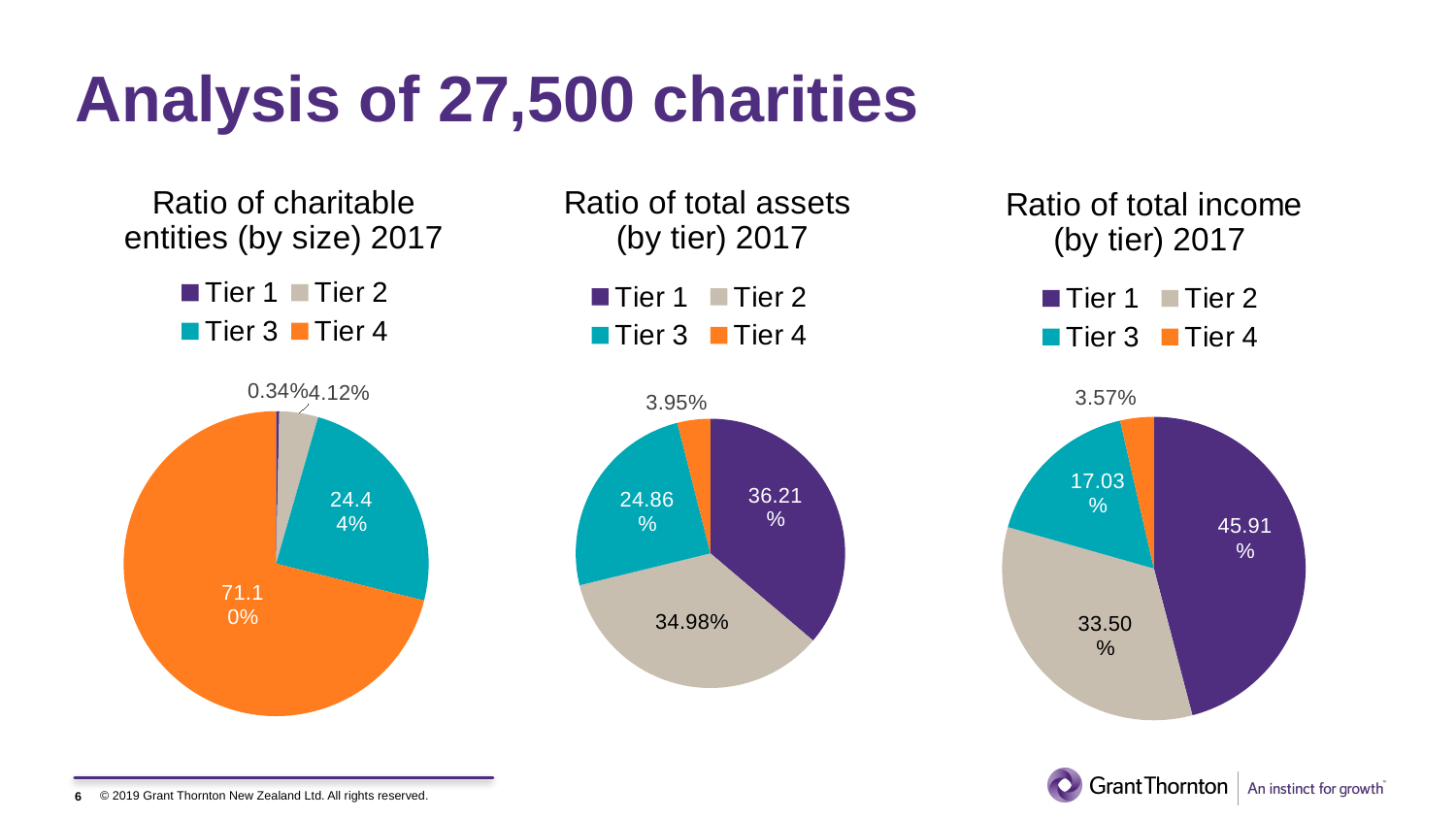
In the 'Ratio of total assets (by tier) 2017' chart, what percentage is Tier 2? 34.98% In the 'Ratio of charitable entities (by size) 2017' chart, what percentage is Tier 4? 71.10% In the 'Ratio of total income (by tier) 2017' chart, what percentage is Tier 3? 17.03% How many series does the legend of the 'Ratio of total income (by tier) 2017' chart list? 4 What type of chart is used for 'Ratio of total assets (by tier) 2017'? Pie chart In the 'Ratio of charitable entities (by size) 2017' chart, what percentage is Tier 1? 0.34% In the 'Ratio of total income (by tier) 2017' chart, which tier has the largest share? Tier 1 In the 'Ratio of total income (by tier) 2017' chart, what is the difference between the Tier 1 and Tier 2 shares? 12.41% In the 'Ratio of charitable entities (by size) 2017' chart, which tier has the largest share? Tier 4 How many charts are shown on the slide? 3 In the 'Ratio of total assets (by tier) 2017' chart, which tier has the smallest share? Tier 4 In the 'Ratio of total assets (by tier) 2017' chart, which is larger, Tier 3 or Tier 4? Tier 3